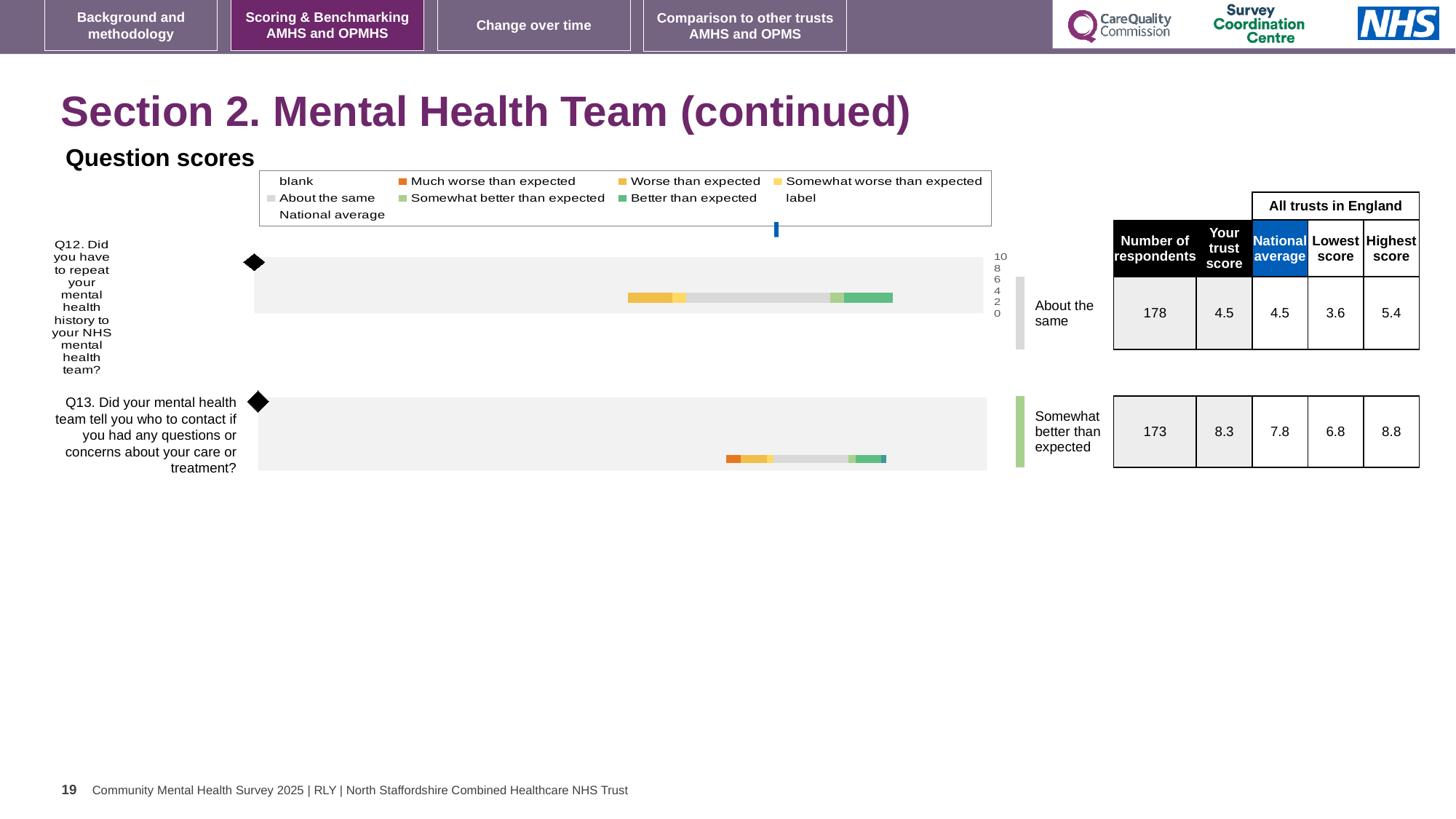
What kind of chart is used to show the question scores for Q12 and Q13? bar chart What benchmark category is shown next to the bar for Q13 (who to contact with questions or concerns)? Somewhat better than expected In the chart legend, which colour represents 'Much worse than expected'? orange For Q13, which is larger: the trust score or the national average? trust score In the chart legend, which colour represents 'Better than expected'? green What is the trust score for Q12 in the question scores table? 4.5 What is the national average score for Q13? 7.8 How many respondents answered Q12? 178 What benchmark category is shown next to the bar for Q12 (repeating mental health history)? About the same What is the difference between the highest score and the lowest score for Q13 across all trusts in England? 2.0 How many questions (categories) are plotted in the question scores chart? 2 What is the trust score for Q13 in the question scores table? 8.3